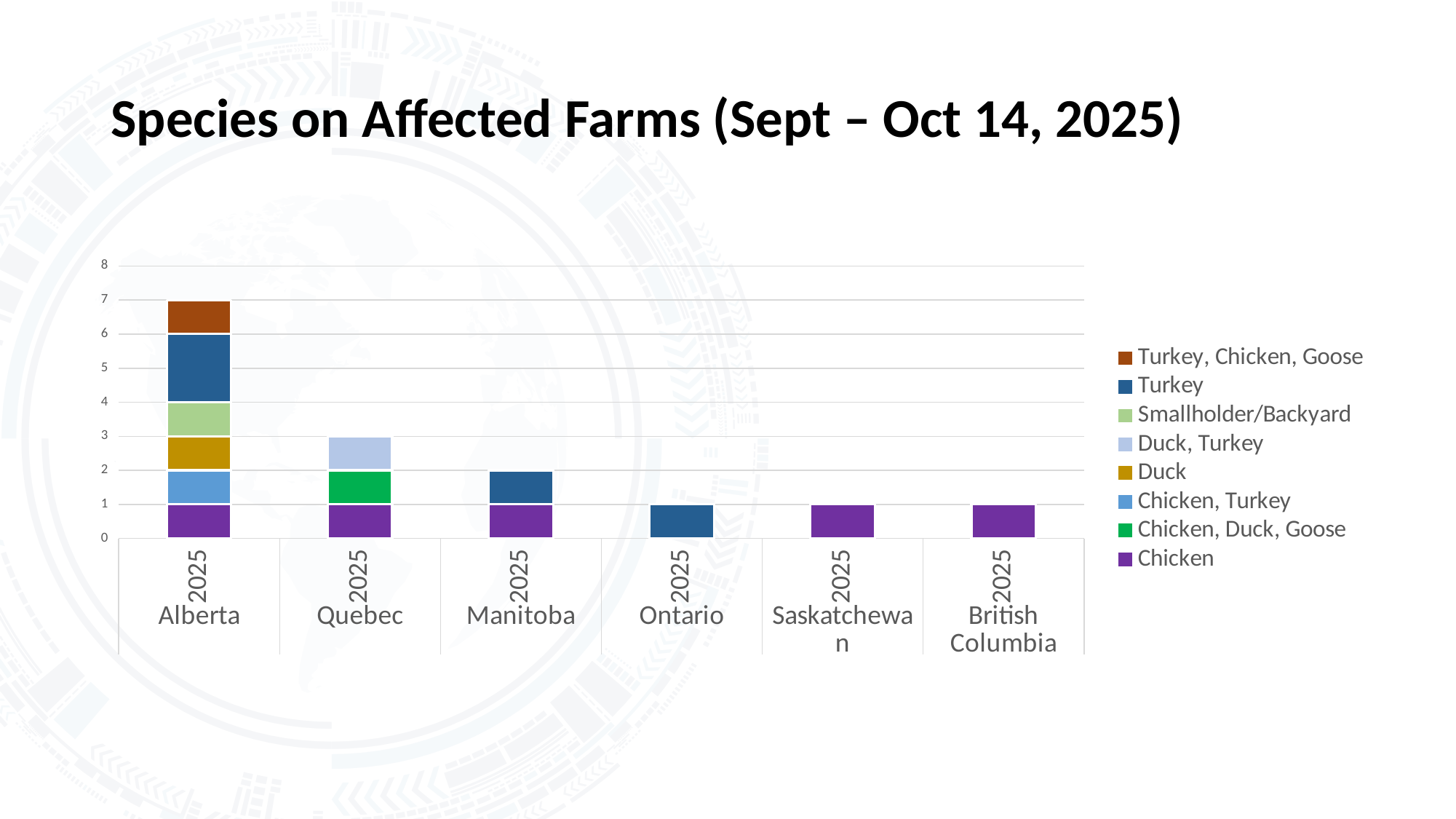
Which has a taller stacked bar, Quebec or Manitoba? Quebec Which series is the only one shown in the bar for Ontario? Turkey What is the total height of the stacked bar for Alberta? 7 Is the total for Alberta greater or less than 6? greater What is the total height of the stacked bar for Quebec? 3 How many series does the legend list? 8 What is the title of the chart? Species on Affected Farms (Sept – Oct 14, 2025) What kind of chart is shown on the slide? Stacked bar chart Which province has the tallest stacked bar? Alberta How many provinces are shown on the x axis of the chart? 6 What is the difference between the total for Alberta and the total for Quebec? 4 What is the total height of the stacked bar for Manitoba? 2